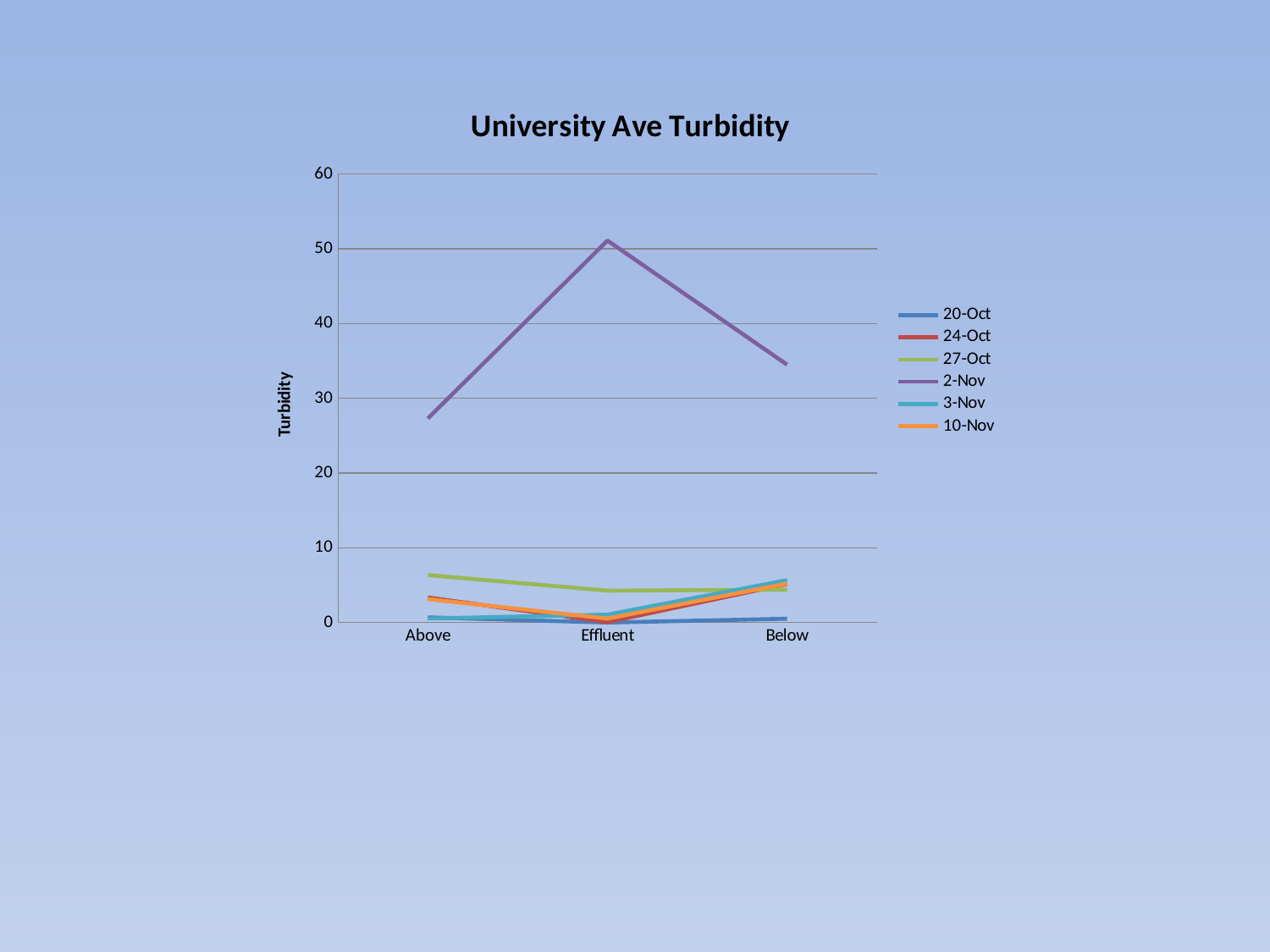
Is the value for 2-Nov at Effluent greater or less than 40? greater What is the title of the chart? University Ave Turbidity For the 2-Nov series, which is larger, the value at Above or the value at Below? Below Which series has the highest value at Effluent? 2-Nov What kind of chart is shown on the slide? line chart Is the value for 2-Nov at Below greater or less than 40? less Is the value for 27-Oct at Above greater or less than 10? less How many categories are shown on the x axis? 3 How many series does the legend list? 6 What is the label on the vertical axis? Turbidity For the 2-Nov series, does the value rise or fall from Above to Effluent? rise